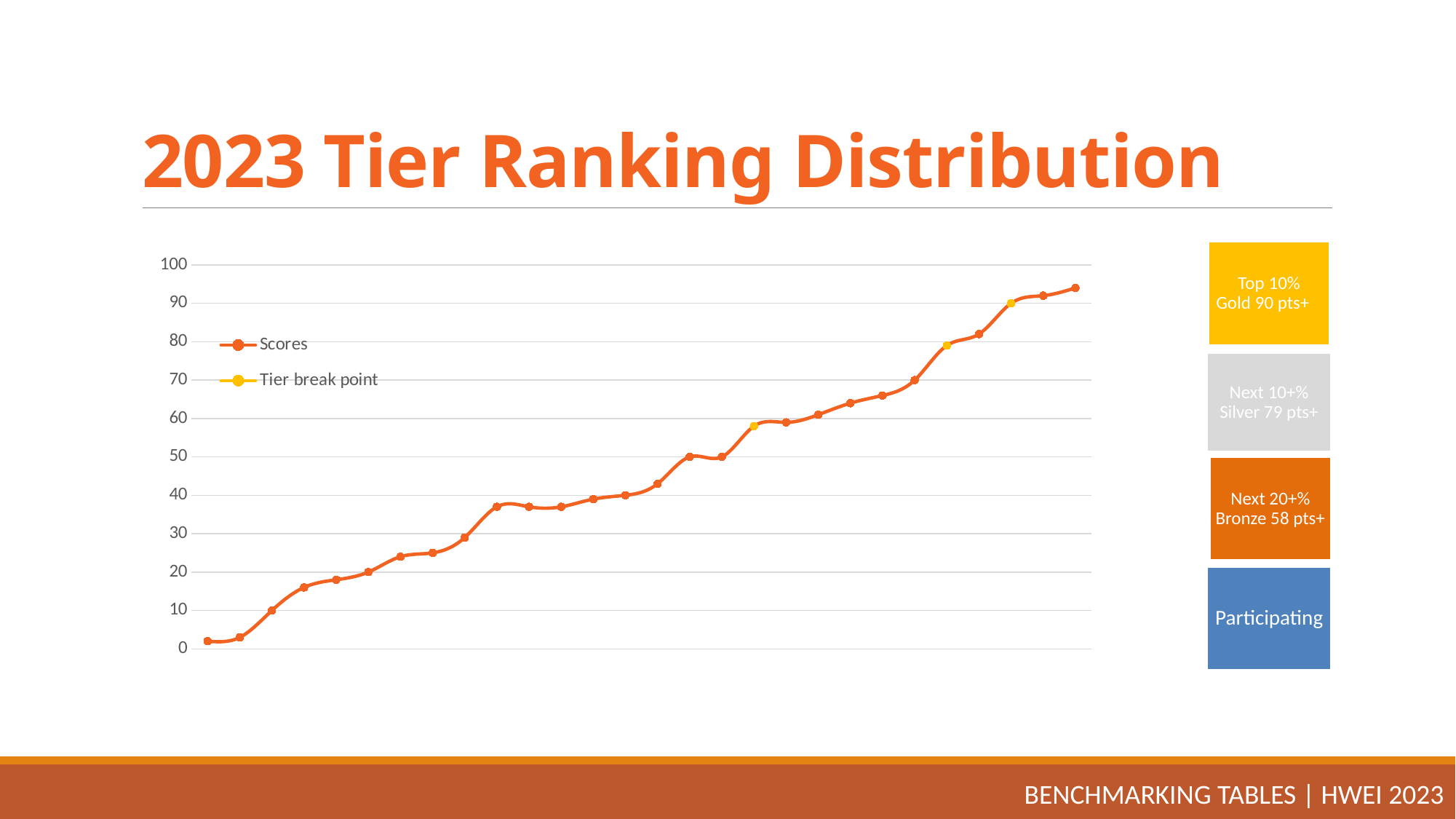
What is the value of the highest Tier break point marker on the chart? 90 What is the highest value shown on the chart's vertical axis? 100 Do the Scores values rise or fall from left to right along the x axis? rise Which is larger, the first Scores point on the left or the last Scores point on the right? the last point on the right Is the lowest Scores value on the chart greater or less than 10? less Is the highest Scores value on the chart greater or less than 90? greater What kind of chart is shown on the slide? line chart How many series does the chart legend list? 2 How many Tier break point markers are plotted on the chart? 3 What colour are the Tier break point markers on the chart? yellow Is the lowest Tier break point marker greater or less than 50? greater What are the two series named in the chart legend? Scores and Tier break point